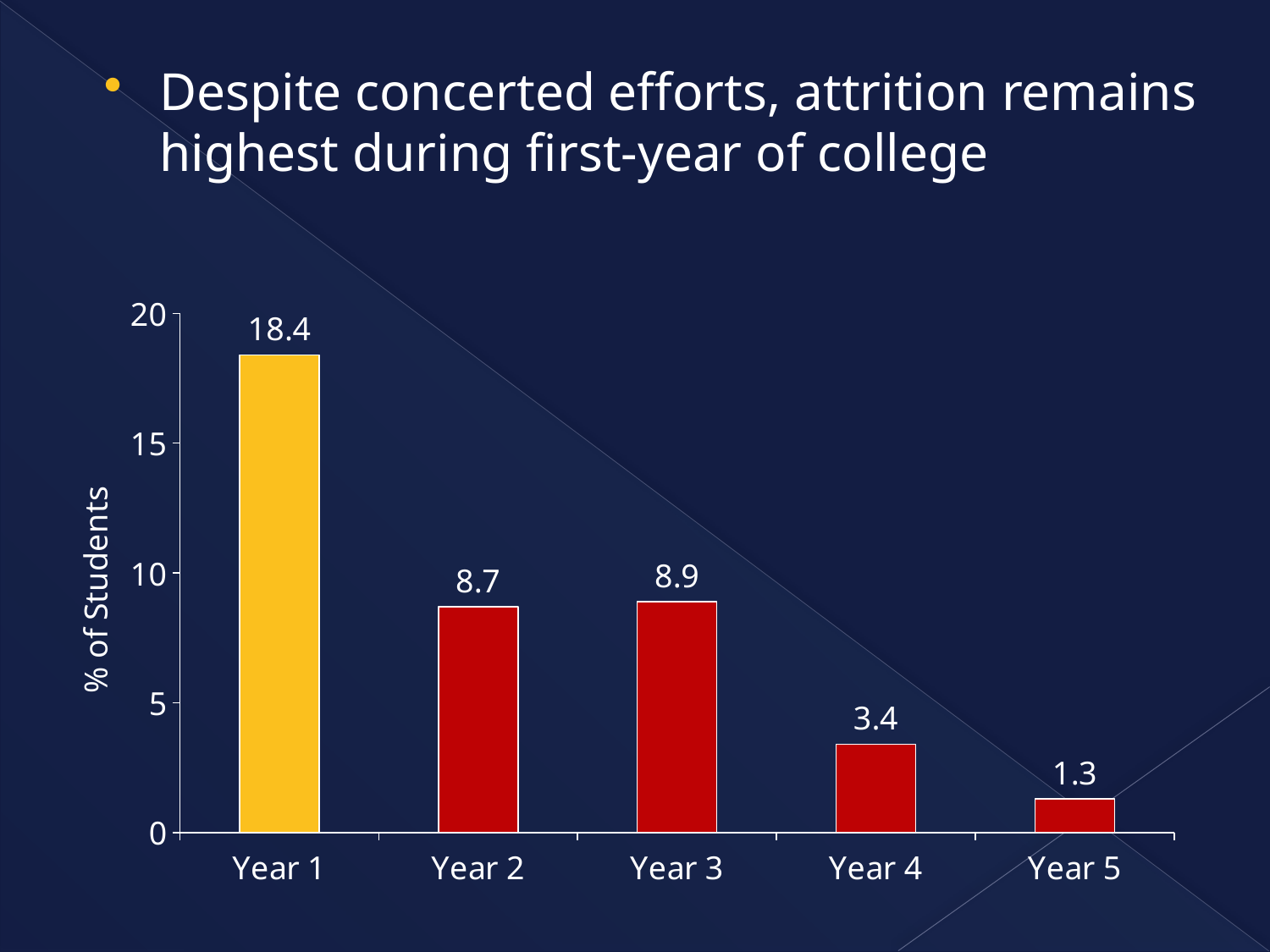
What kind of chart is shown on the slide? bar chart What is the value for Year 5? 1.3 What is the value for Year 1? 18.4 Which is larger, the value for Year 2 or the value for Year 4? Year 2 What is the value for Year 4? 3.4 Is the value for Year 3 greater or less than 10? less How many years are shown on the x axis? 5 What is the label of the y axis? % of Students Which year has the lowest value? Year 5 What is the difference between the values for Year 1 and Year 2? 9.7 What is the difference between the values for Year 4 and Year 5? 2.1 Which year has the highest value? Year 1